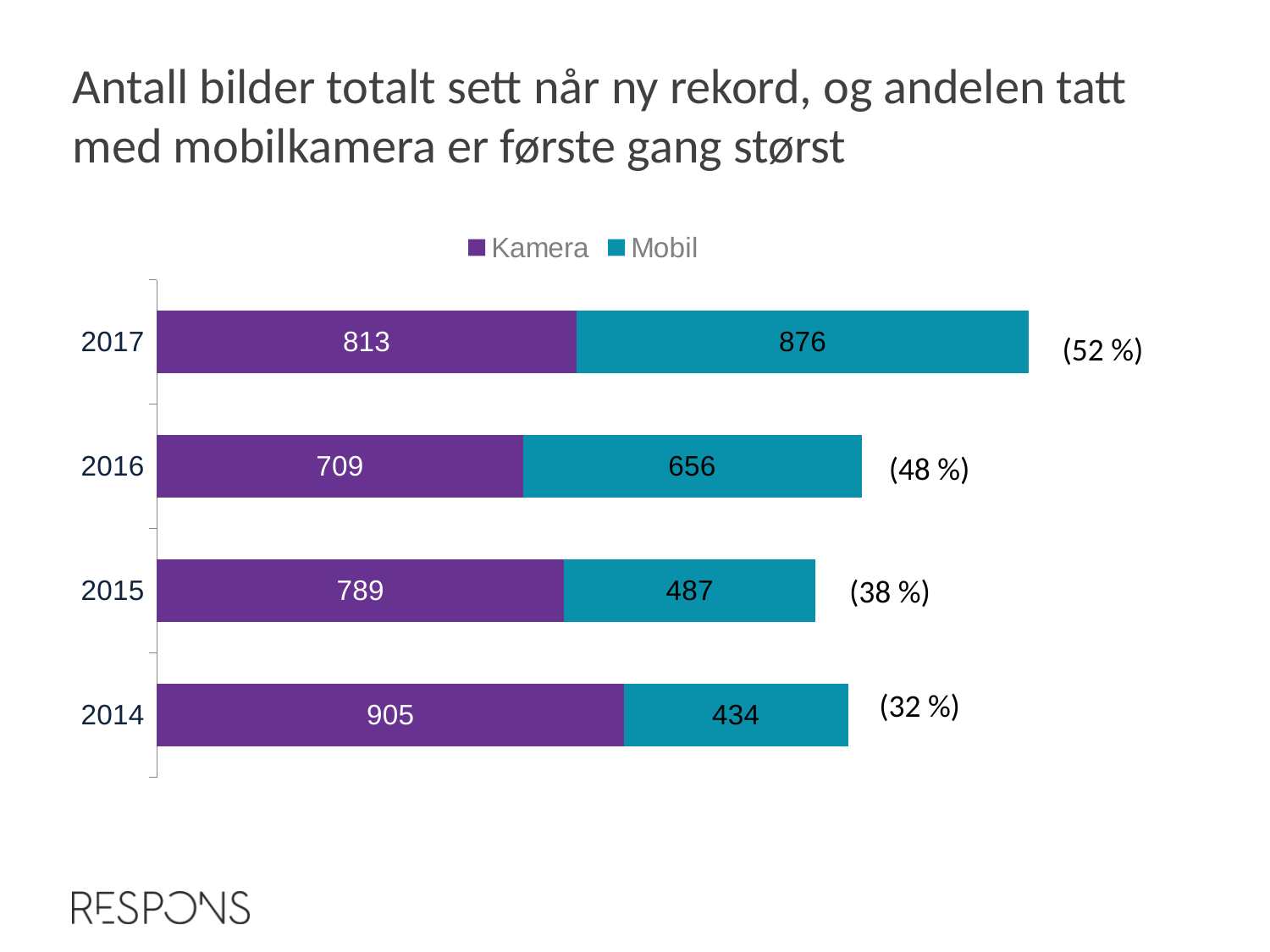
What is the Mobil value for 2014? 434 What is the difference between the Kamera and Mobil values for 2015? 302 What is the Mobil value for 2016? 656 What percentage is shown next to the bar for 2015? (38 %) Which year has the lowest Kamera value? 2016 What is the total of the stacked bar for 2017? 1689 How many years are shown on the chart? 4 What is the Kamera value for 2017? 813 Which year has the highest Mobil value? 2017 How many series does the legend list? 2 What kind of chart is shown on the slide? Stacked bar chart Which is larger for 2014, the Kamera value or the Mobil value? Kamera